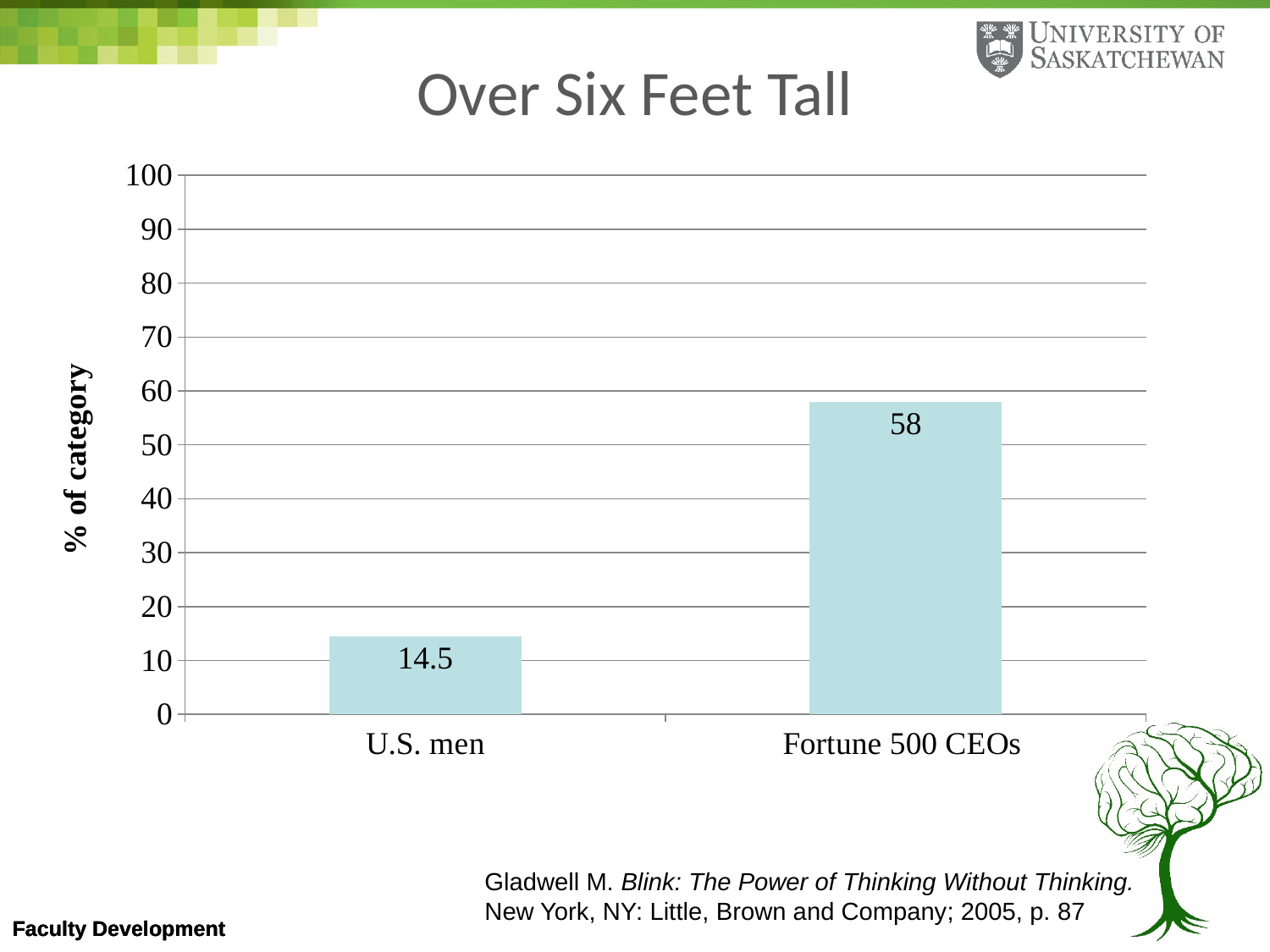
Which category has the lowest value? U.S. men What kind of chart is shown on the slide? bar chart Is the value for U.S. men greater or less than 20? less What is the value for U.S. men? 14.5 What is the label of the vertical axis? % of category Which category has the highest value? Fortune 500 CEOs Which is larger, the value for U.S. men or the value for Fortune 500 CEOs? Fortune 500 CEOs Is the value for Fortune 500 CEOs greater or less than 50? greater What is the difference between the values for Fortune 500 CEOs and U.S. men? 43.5 What is the title of the chart? Over Six Feet Tall How many categories are shown in the chart? 2 What is the value for Fortune 500 CEOs? 58